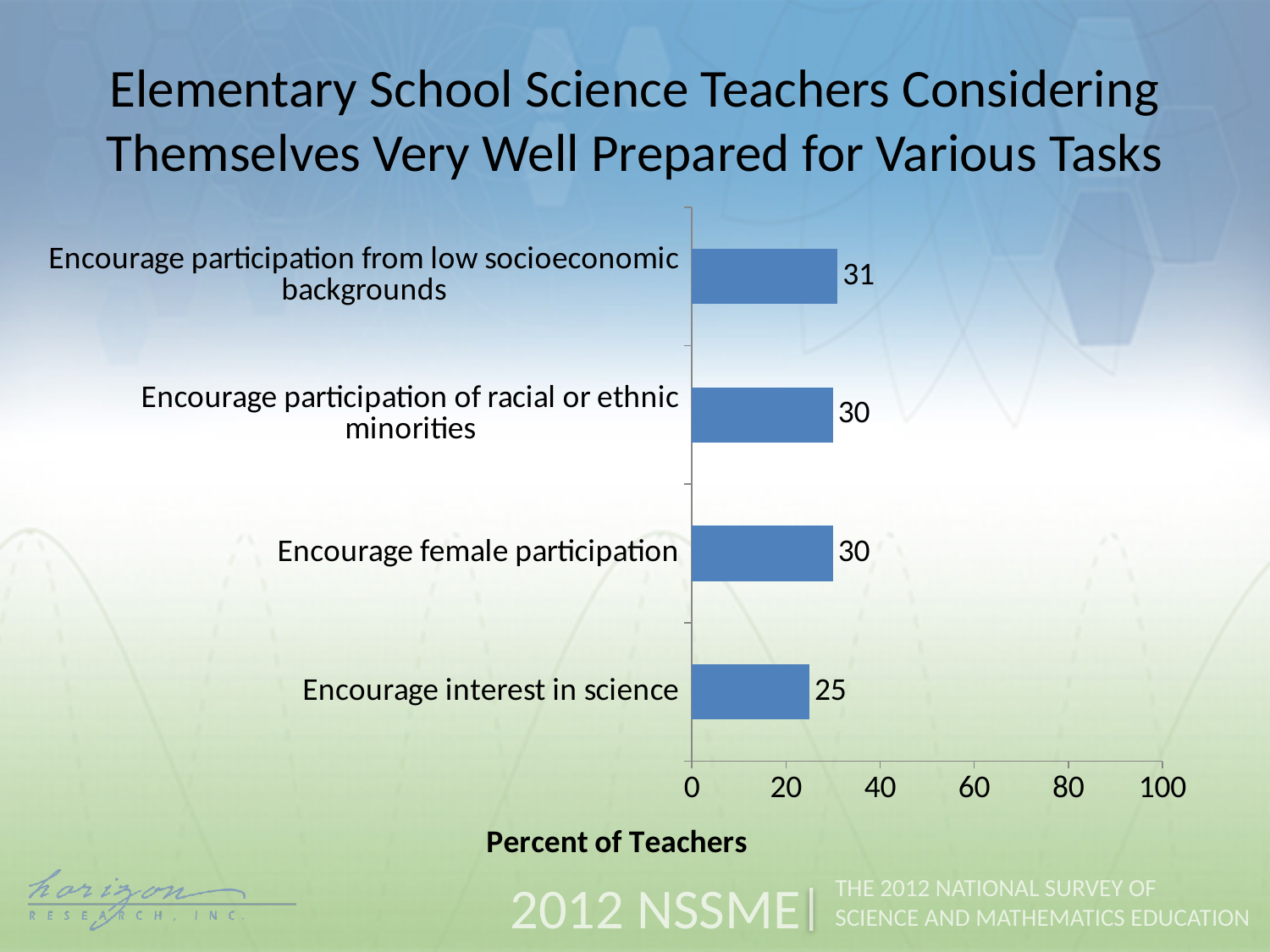
Which task has the lowest percent of teachers? Encourage interest in science Which task has the highest percent of teachers? Encourage participation from low socioeconomic backgrounds What is the difference between the values for "Encourage participation from low socioeconomic backgrounds" and "Encourage interest in science"? 6 What percent of teachers consider themselves very well prepared to encourage participation from low socioeconomic backgrounds? 31 What is the value for "Encourage female participation"? 30 What is the label of the horizontal axis? Percent of Teachers How many tasks are shown in the chart? 4 Is the value for "Encourage interest in science" greater or less than 40? less Which is larger: the value for "Encourage female participation" or "Encourage interest in science"? Encourage female participation What kind of chart is shown on the slide? Bar chart What is the value for "Encourage interest in science"? 25 What is the value for "Encourage participation of racial or ethnic minorities"? 30